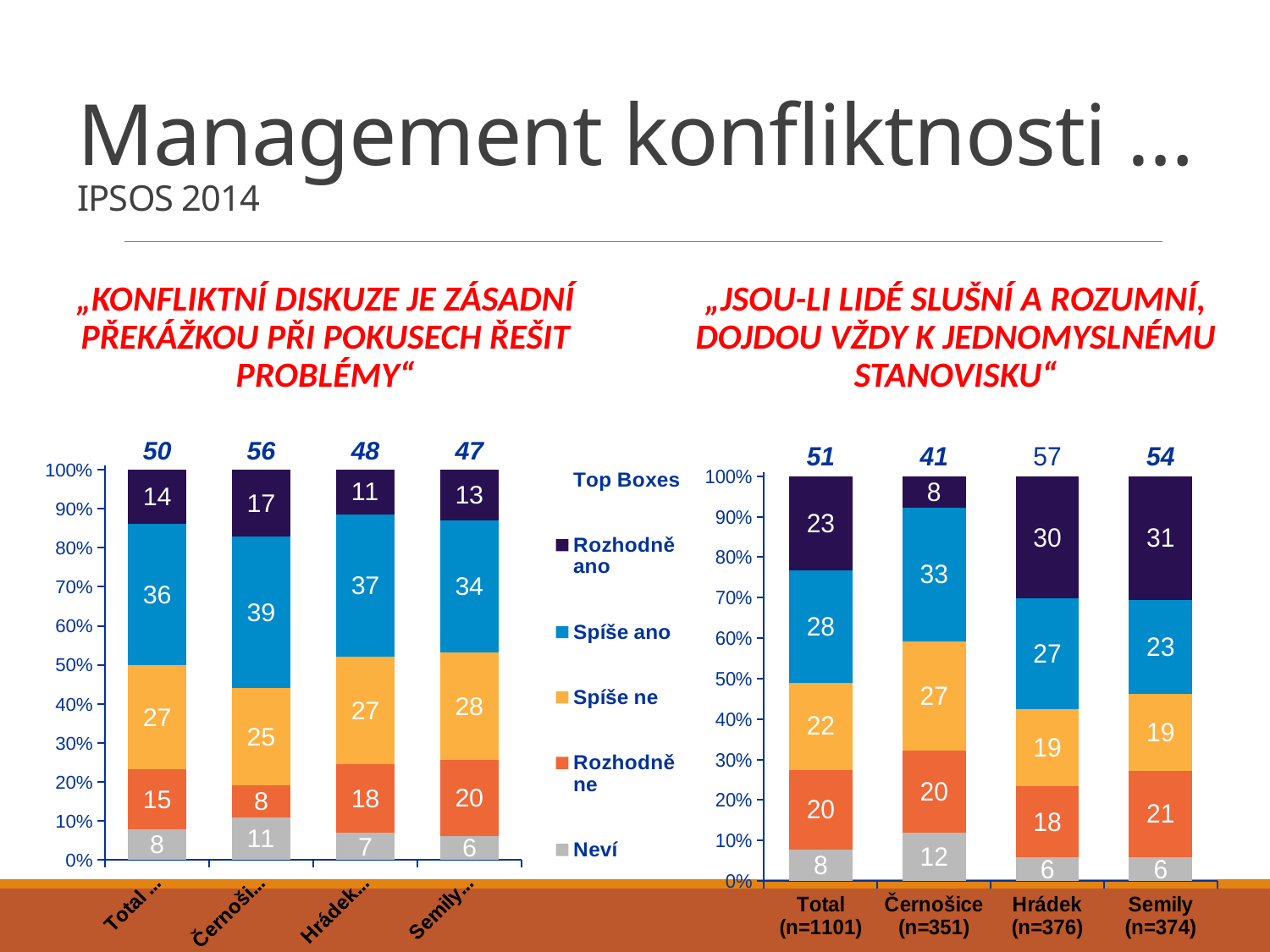
What kind of chart is used on this slide? Stacked bar chart In the right chart, which category has the lowest Top Boxes value? Černošice (n=351) How many categories are shown in the right chart? 4 In the right chart, what is the Top Boxes value shown above the Černošice (n=351) bar? 41 In the left chart ("Konfliktní diskuze je zásadní překážkou..."), what is the Top Boxes value above the Total bar? 50 In the right chart, what is the Neví value for Černošice (n=351)? 12 How many series does the legend list? 6 In the right chart, which category has the highest Top Boxes value? Hrádek (n=376) In the left chart, what is the Rozhodně ne value for Total? 15 In the right chart ("Jsou-li lidé slušní a rozumní..."), what is the Rozhodně ano value for Hrádek (n=376)? 30 In the right chart, which has the larger Spíše ano value: Total (n=1101) or Černošice (n=351)? Černošice (n=351) In the right chart, what is the difference between the Rozhodně ano values for Semily (n=374) and Total (n=1101)? 8